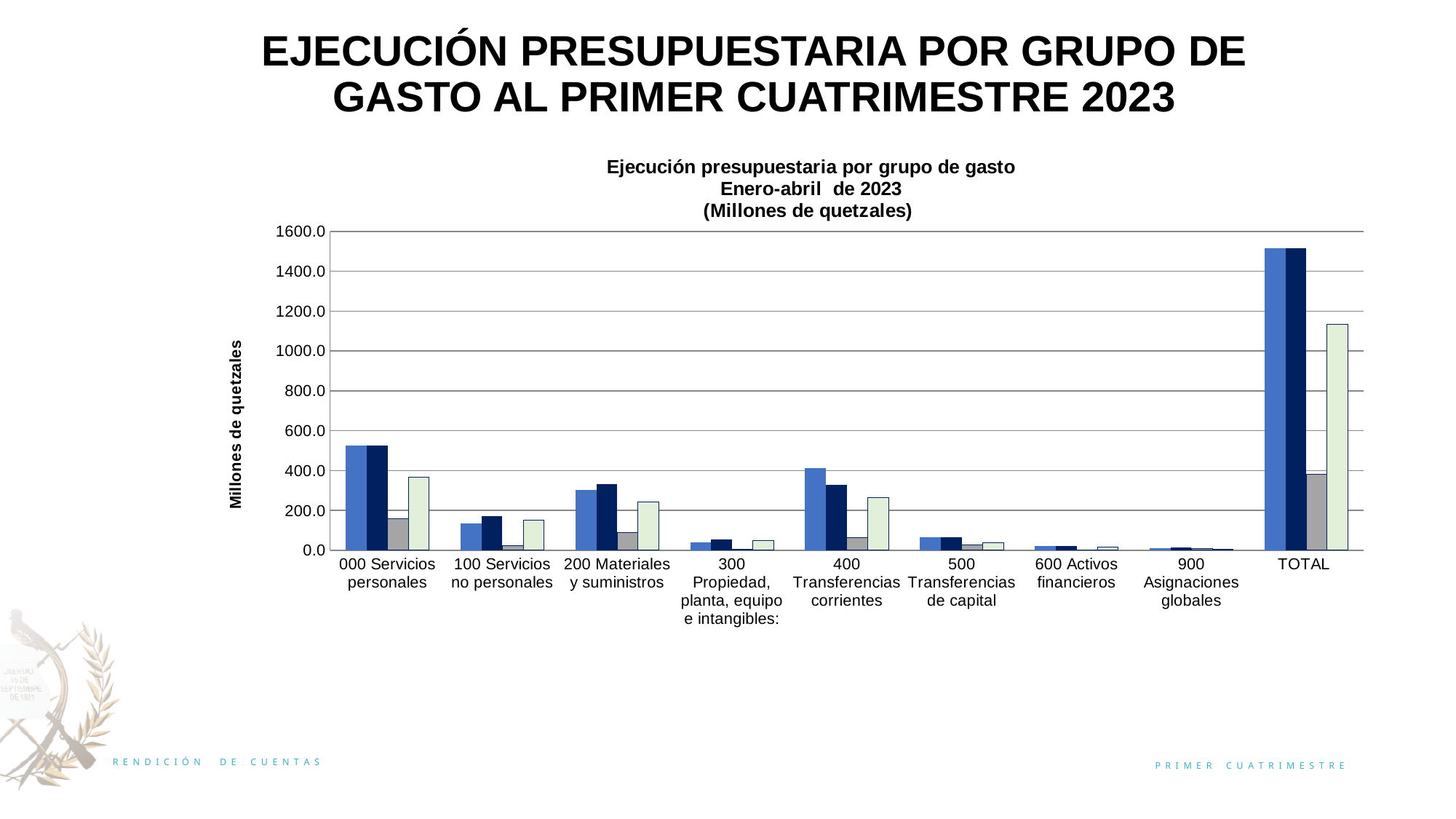
Is the light-blue bar for TOTAL greater or less than 1400? greater What is the label on the vertical axis of the chart? Millones de quetzales What type of chart is shown on the slide? bar chart How many bars are plotted for each category in the chart? 4 Excluding TOTAL, which category has the tallest light-blue bar? 000 Servicios personales Which has the larger light-green bar: 000 Servicios personales or 400 Transferencias corrientes? 000 Servicios personales Which category has the smallest bars in the chart? 900 Asignaciones globales Is the gray bar for 000 Servicios personales greater or less than 200? less Is the light-green bar for TOTAL greater or less than 1200? less Which category has the tallest bars in the chart? TOTAL How many categories are shown along the x axis of the chart? 9